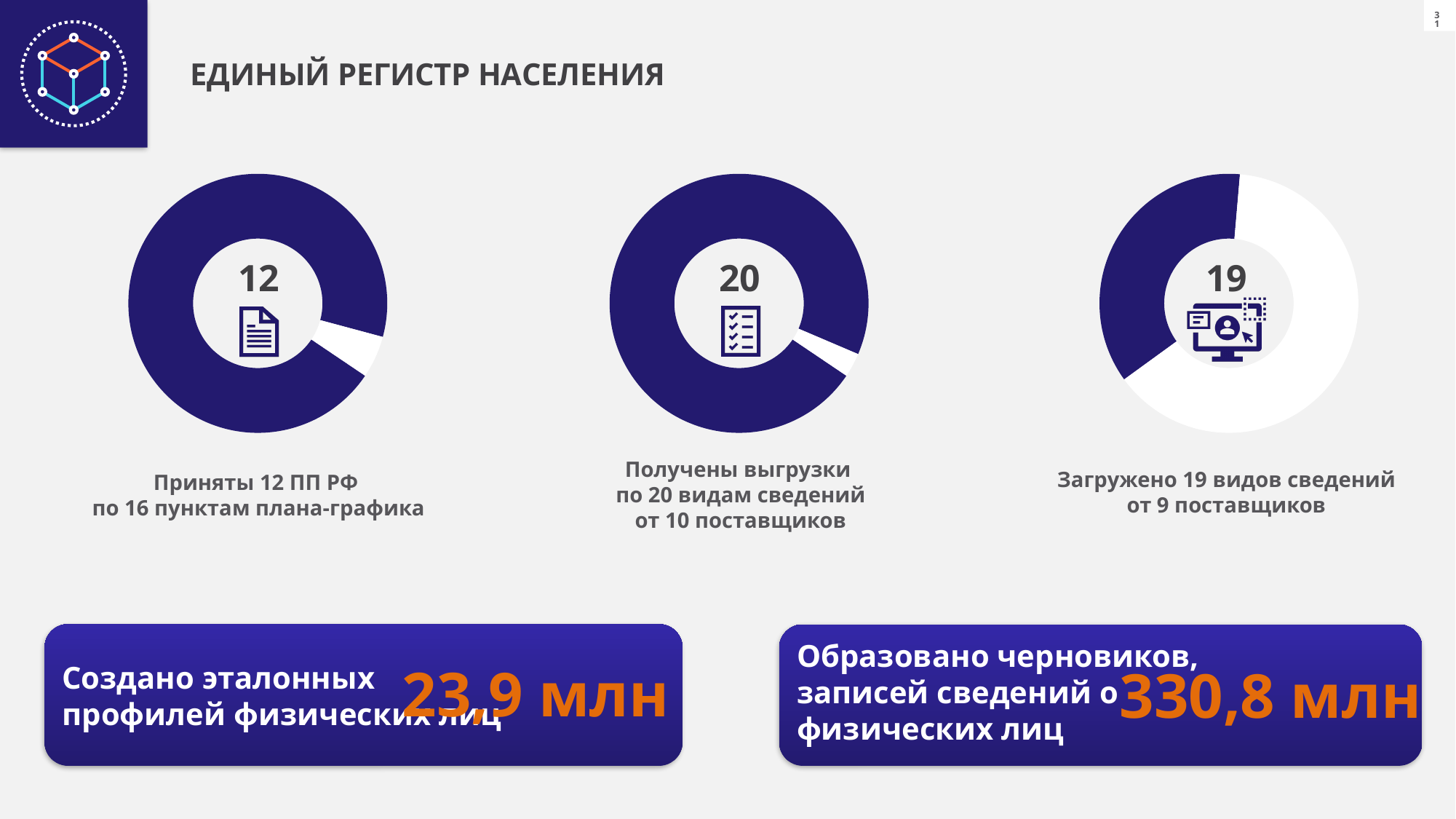
According to the caption under the right donut chart, from how many suppliers (поставщиков) were the 19 types of data loaded? 9 What number is printed in the centre of the middle donut chart? 20 What is the difference between the centre numbers of the middle and left donut charts? 8 According to the caption under the left donut chart, how many items of the plan-schedule (пунктов плана-графика) are mentioned? 16 How many donut charts are shown on the slide? 3 What kind of chart is used for the three figures on the slide? Donut (pie) chart Which donut chart has the smallest centre number: left, middle or right? Left Is the centre number of the right donut chart larger or smaller than that of the middle donut chart? Smaller What number is printed in the centre of the right donut chart? 19 Which donut chart has the smallest filled (dark) share of its ring: left, middle or right? Right What number is printed in the centre of the left donut chart? 12 Which donut chart has the largest centre number: left, middle or right? Middle